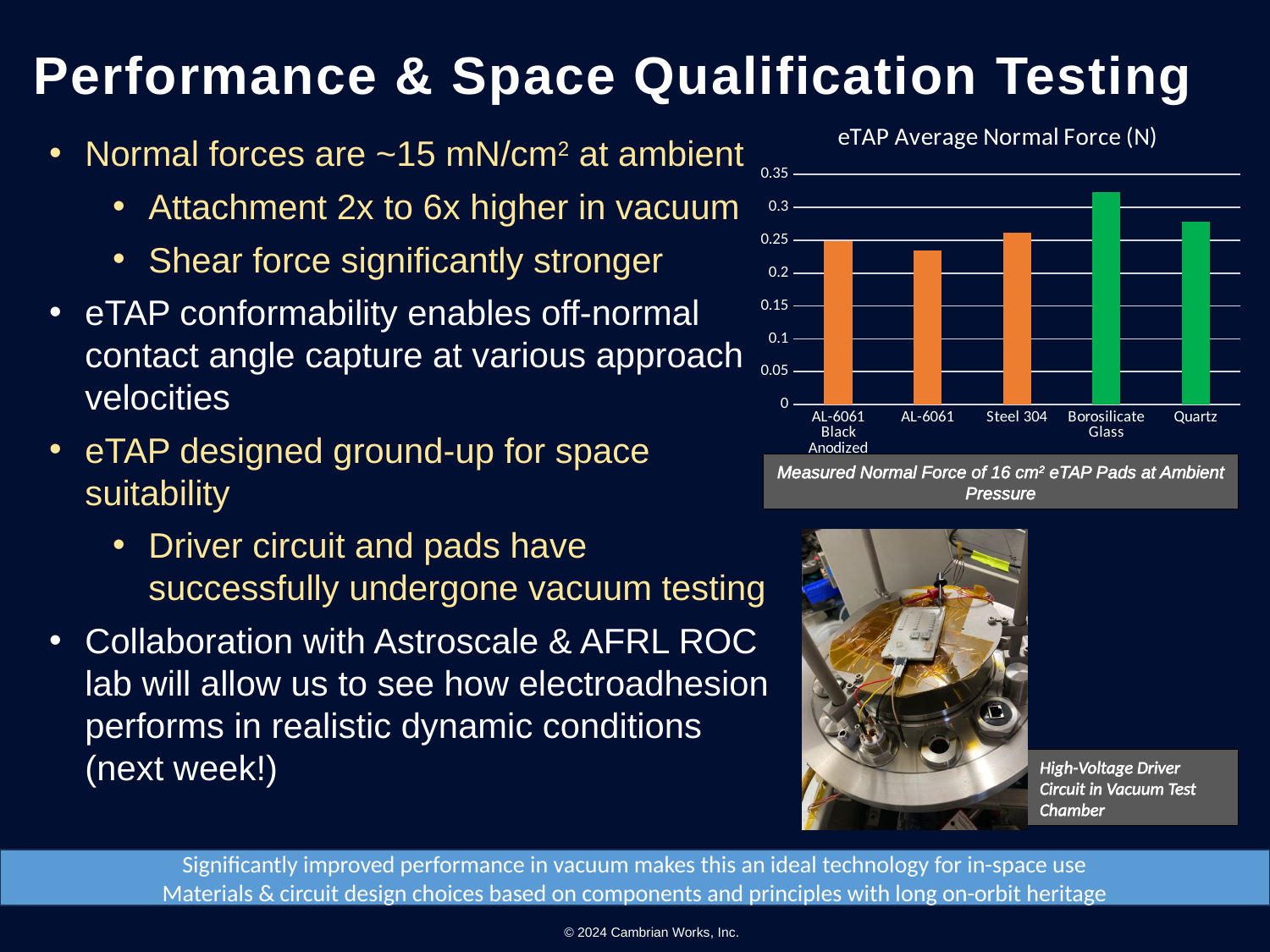
Which has a higher average normal force, Quartz or Steel 304? Quartz Which has a higher average normal force, Borosilicate Glass or Quartz? Borosilicate Glass Which materials are shown with green bars in the chart? Borosilicate Glass and Quartz Is the value for Quartz greater or less than 0.25? greater Which material has the lowest average normal force in the chart? AL-6061 Is the value for AL-6061 greater or less than 0.25? less Is the value for Borosilicate Glass greater or less than 0.3? greater How many materials are plotted in the eTAP Average Normal Force chart? 5 Which material has the highest average normal force in the chart? Borosilicate Glass What is the title of the chart on the slide? eTAP Average Normal Force (N) What kind of chart is shown on the slide? bar chart